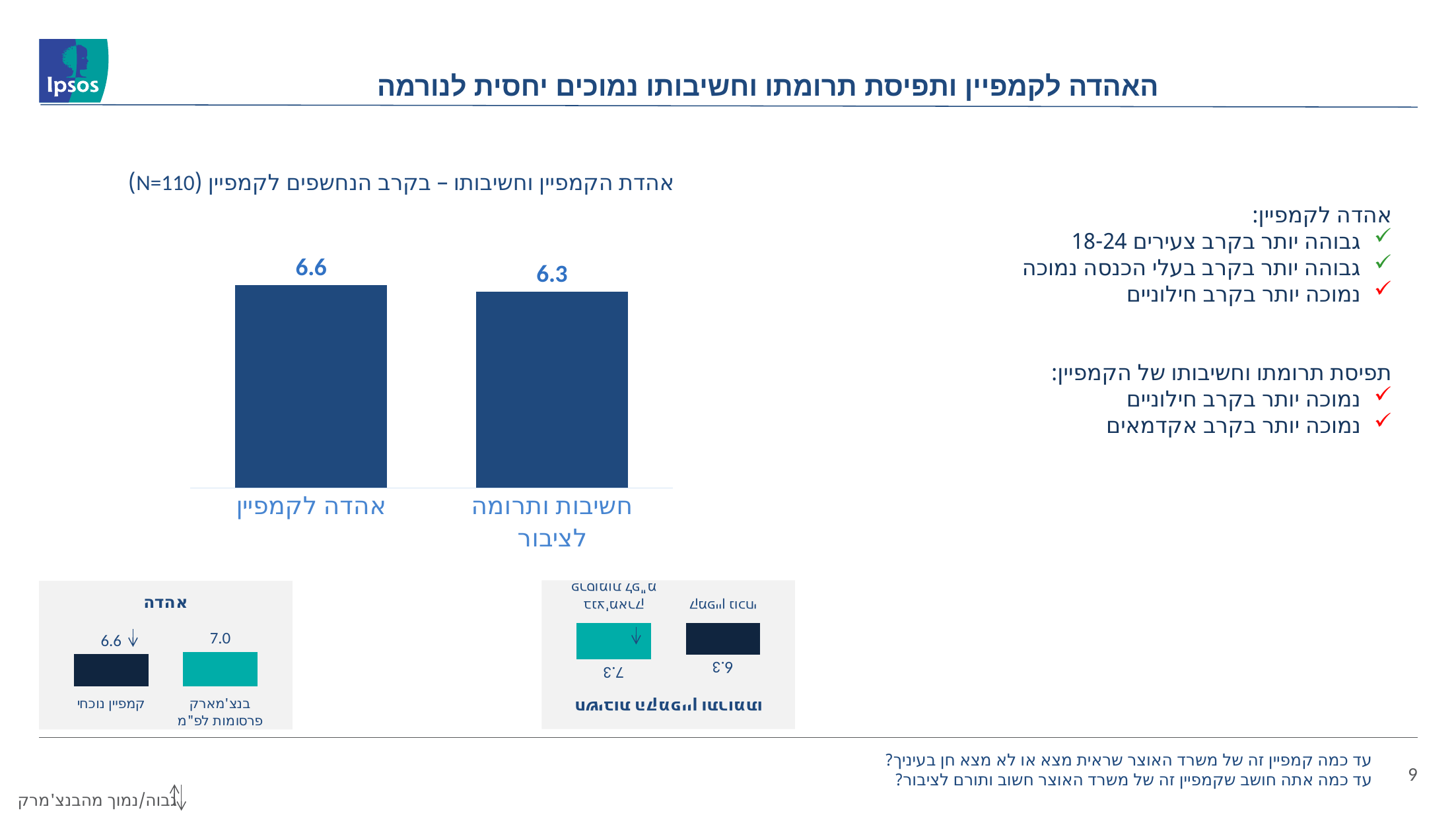
In the main chart 'אהדת הקמפיין וחשיבותו – בקרב הנחשפים לקמפיין', what is the value for 'חשיבות ותרומה לציבור'? 6.3 In the small 'אהדה' chart at the bottom left, which is larger: 'קמפיין נוכחי' or 'בנצ'מארק פרסומות לפ"מ'? בנצ'מארק פרסומות לפ"מ In the small 'אהדה' chart at the bottom left, what is the value for 'בנצ'מארק פרסומות לפ"מ'? 7.0 What kind of chart is the main chart 'אהדת הקמפיין וחשיבותו – בקרב הנחשפים לקמפיין'? Bar chart What sample size (N) is stated in the title of the main chart? N=110 In the main chart 'אהדת הקמפיין וחשיבותו – בקרב הנחשפים לקמפיין', what is the value for 'אהדה לקמפיין'? 6.6 In the main chart 'אהדת הקמפיין וחשיבותו – בקרב הנחשפים לקמפיין', which category has the highest value? אהדה לקמפיין How many bars are plotted in the main chart 'אהדת הקמפיין וחשיבותו – בקרב הנחשפים לקמפיין'? 2 In the small 'אהדה' chart at the bottom left, what is the value for 'קמפיין נוכחי'? 6.6 In the main chart 'אהדת הקמפיין וחשיבותו – בקרב הנחשפים לקמפיין', which is larger: 'אהדה לקמפיין' or 'חשיבות ותרומה לציבור'? אהדה לקמפיין In the main chart 'אהדת הקמפיין וחשיבותו – בקרב הנחשפים לקמפיין', what is the difference between the values for 'אהדה לקמפיין' and 'חשיבות ותרומה לציבור'? 0.3 In the main chart 'אהדת הקמפיין וחשיבותו – בקרב הנחשפים לקמפיין', which category has the lowest value? חשיבות ותרומה לציבור